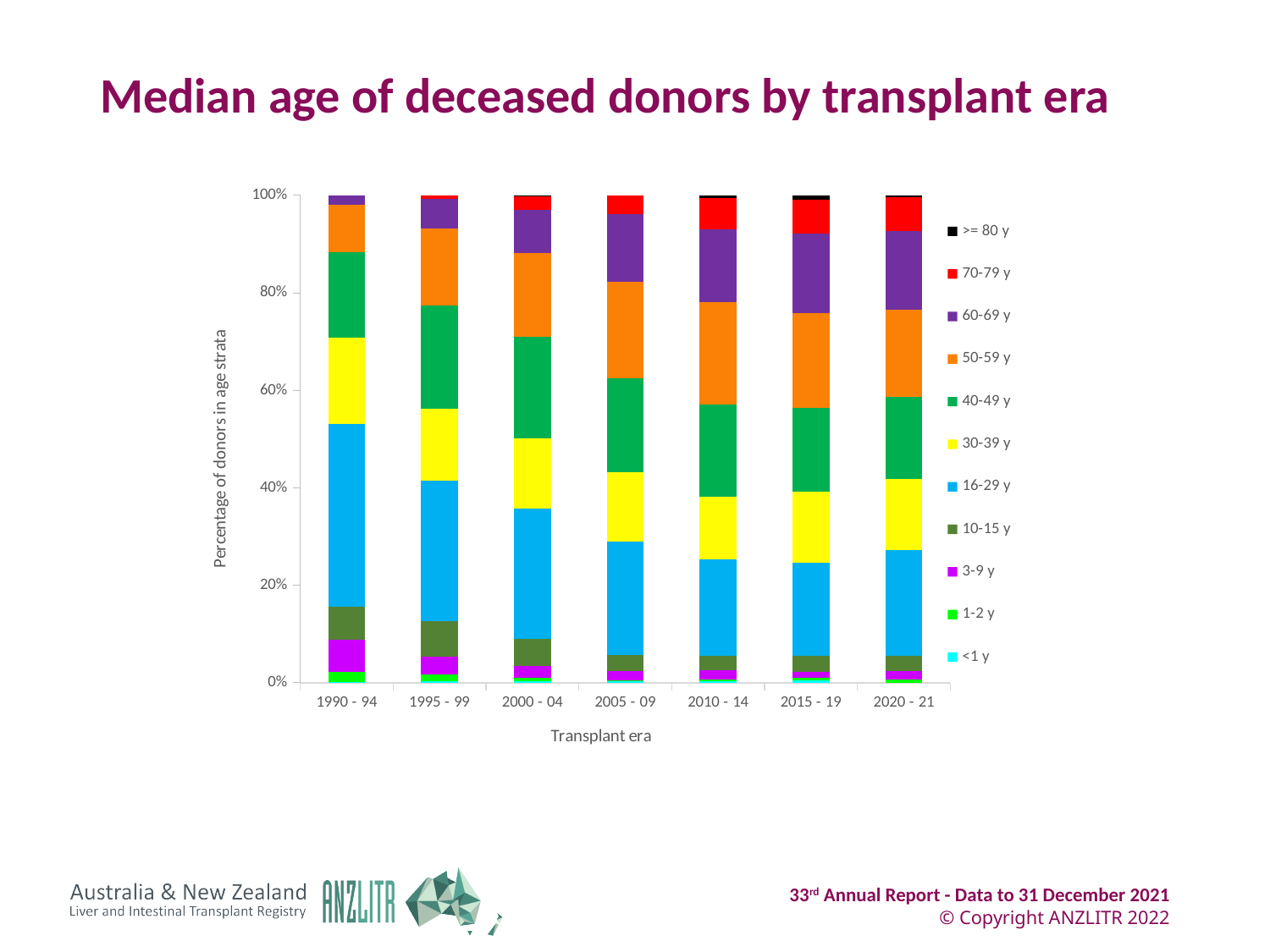
Is the share of donors aged 60-69 y larger in the 1990 - 94 era or the 2020 - 21 era? 2020 - 21 How many transplant eras are shown on the x axis? 7 How many age strata does the legend list? 11 Is the share of donors aged 60-69 y in the 1990 - 94 era greater or less than 20%? less Does the share of donors aged 16-29 y generally rise or fall from the 1990 - 94 era to the 2020 - 21 era? fall Which transplant era has the largest share of donors aged 16-29 y? 1990 - 94 Is the share of donors aged 16-29 y in the 1990 - 94 era greater or less than 20%? greater What kind of chart is shown on the slide? Stacked bar chart Which transplant era has the largest share of donors aged 3-9 y? 1990 - 94 What is the total height of each stacked bar? 100% What is the title of the chart? Median age of deceased donors by transplant era What is the label of the y axis? Percentage of donors in age strata